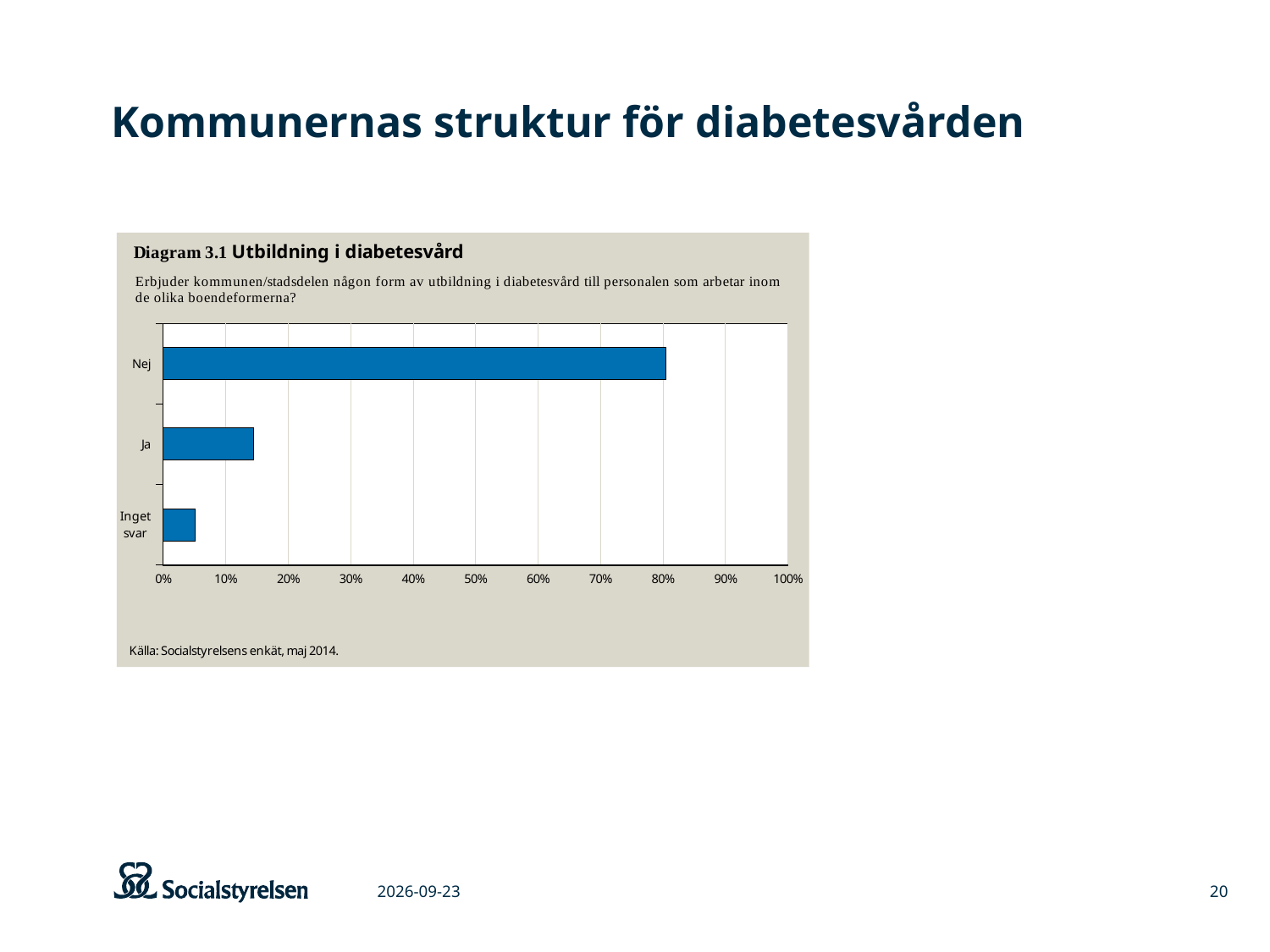
What kind of chart is shown in Diagram 3.1 Utbildning i diabetesvård? bar chart How many categories are plotted in the chart? 3 Is the value for Ja greater or less than 10%? greater Which category has the lowest value in the chart? Inget svar Which is larger, the value for Nej or the value for Ja? Nej Is the value for Ja greater or less than 20%? less Which category has the highest value in the chart? Nej Which is larger, the value for Ja or the value for Inget svar? Ja Is the value for Nej greater or less than 70%? greater What is the title of the chart on the slide? Diagram 3.1 Utbildning i diabetesvård What source is cited below the chart? Källa: Socialstyrelsens enkät, maj 2014.